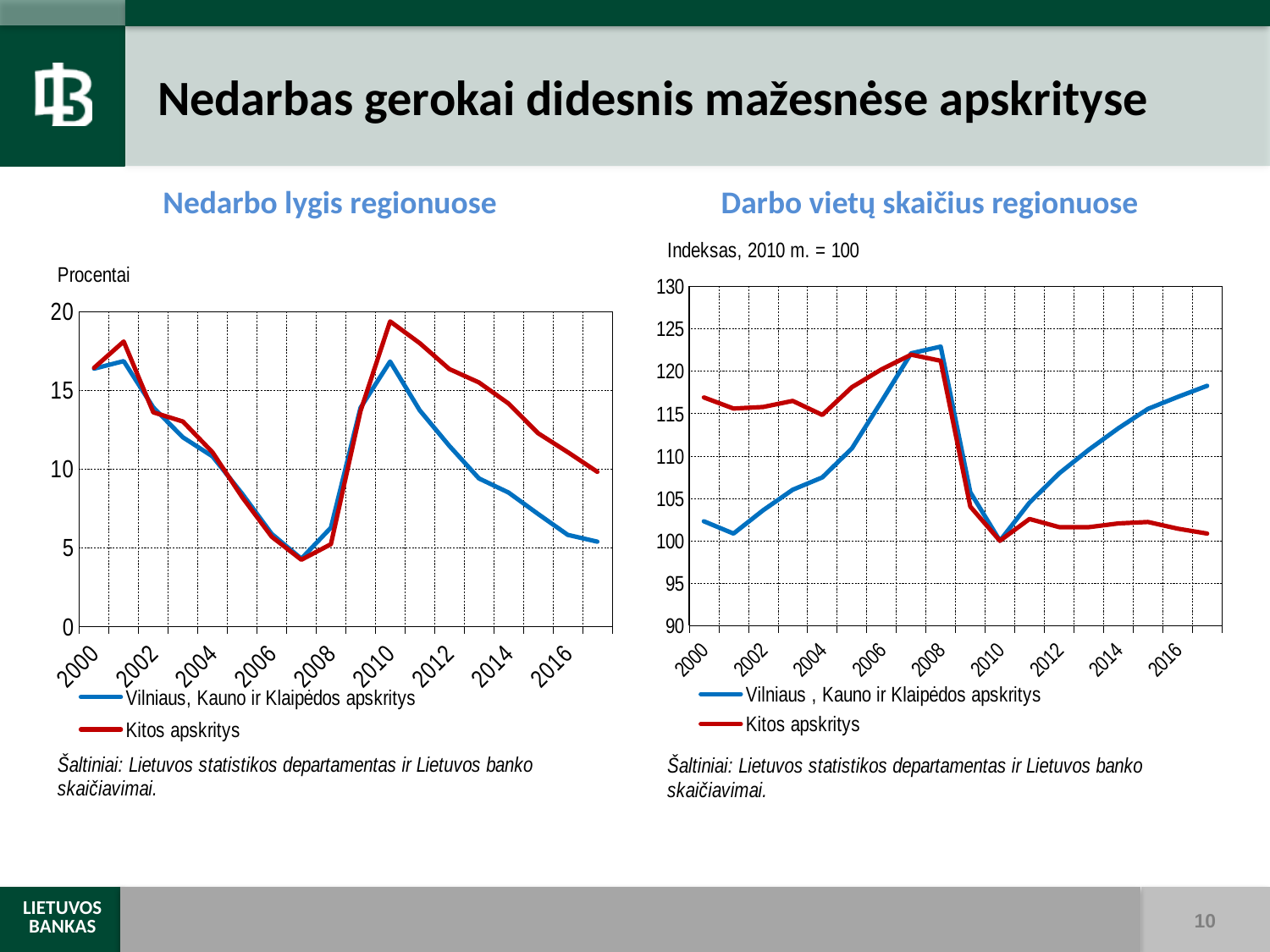
In the left chart "Nedarbo lygis regionuose", which series has the higher value in 2016? Kitos apskritys In the right chart "Darbo vietų skaičius regionuose", what is the index value in the base year 2010? 100 In the right chart "Darbo vietų skaičius regionuose", which series has the higher value in 2016? Vilniaus, Kauno ir Klaipėdos apskritys In the left chart "Nedarbo lygis regionuose", do the values rise or fall from 2010 to 2016? fall In the left chart "Nedarbo lygis regionuose", is the value for Vilniaus, Kauno ir Klaipėdos apskritys in 2016 greater or less than 10? less In the right chart "Darbo vietų skaičius regionuose", does the Vilniaus, Kauno ir Klaipėdos apskritys line rise or fall from 2010 to 2016? rise In the left chart "Nedarbo lygis regionuose", is the value for Kitos apskritys in 2010 greater or less than 15? greater How many series does the legend of the right chart "Darbo vietų skaičius regionuose" list? 2 What kind of chart is the left chart titled "Nedarbo lygis regionuose"? line chart In the right chart "Darbo vietų skaičius regionuose", is the value for Kitos apskritys in 2016 greater or less than 105? less What unit is shown on the y axis of the left chart "Nedarbo lygis regionuose"? Procentai